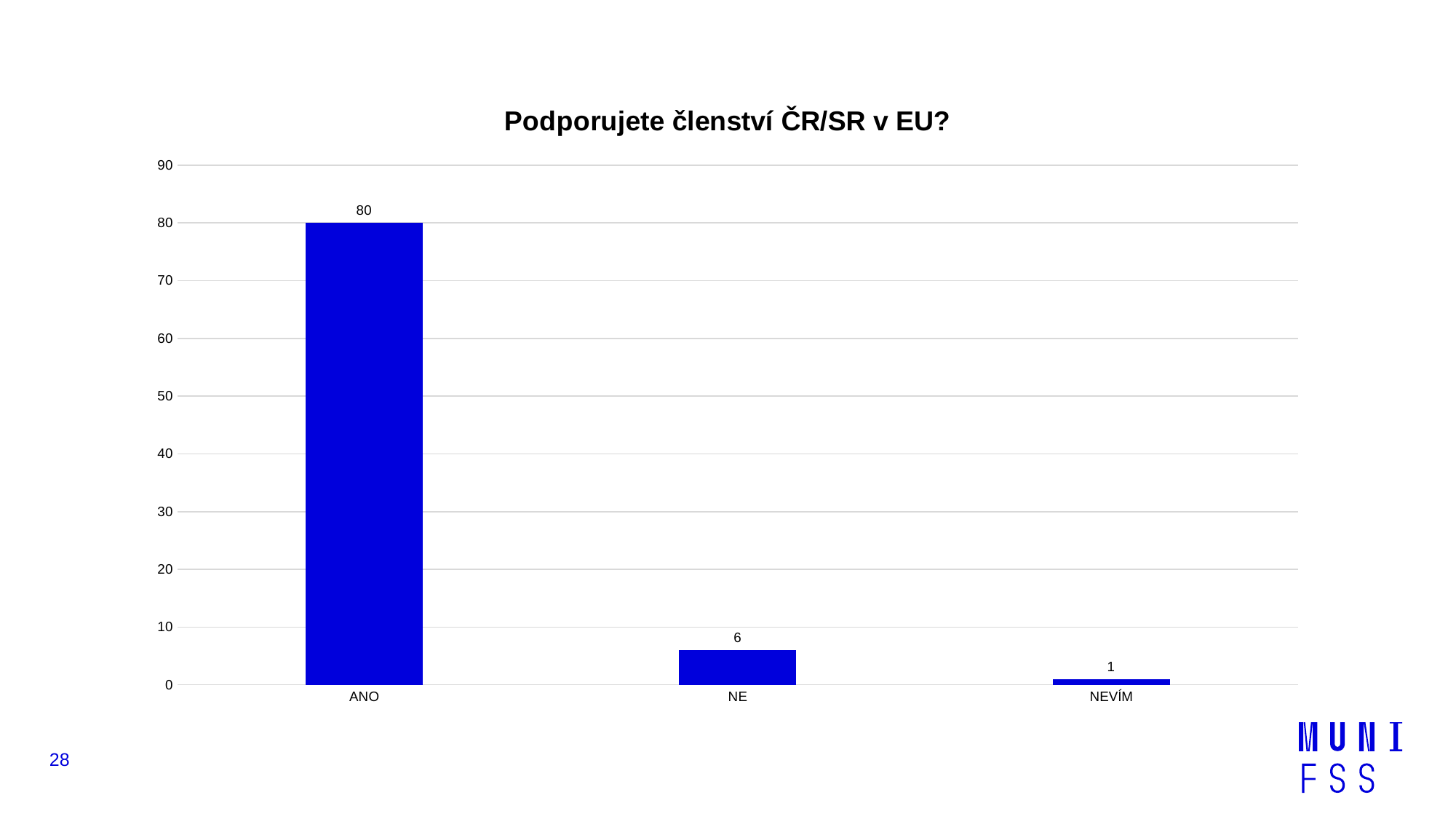
What is the difference between the values for ANO and NE? 74 What is the difference between the values for NE and NEVÍM? 5 What is the value for ANO? 80 What kind of chart is shown on the slide? bar chart Is the value for ANO greater or less than 70? greater How many categories are shown on the x axis? 3 What is the value for NEVÍM? 1 Which category has the lowest value? NEVÍM What is the title of the chart? Podporujete členství ČR/SR v EU? What is the value for NE? 6 Which category has the highest value? ANO Which is larger, the value for NE or the value for NEVÍM? NE